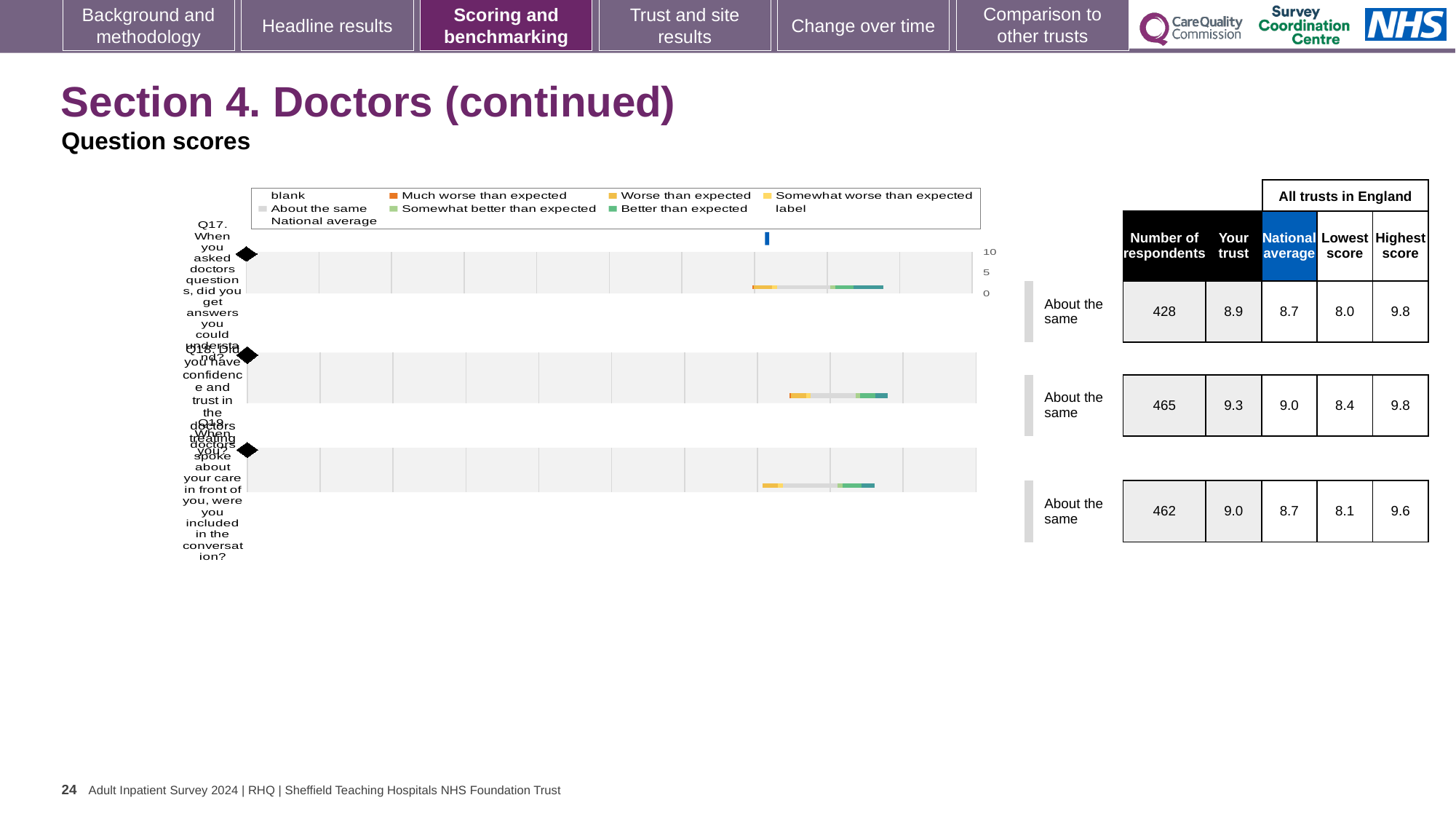
What kind of chart is used to show the question scores for Q17, Q18 and Q19? bar chart In the chart legend, what does the blue line marker represent? National average In the table beside the charts, what is the 'Your trust' score for Q17? 8.9 How many questions (Q17, Q18, Q19) have a benchmarking chart on this slide? 3 In the table beside the charts, how many respondents answered Q19? 462 In the table beside the charts, what is the Highest score for Q18? 9.8 In the table beside the charts, what is the National average score for Q18? 9.0 What benchmark category is shown next to the Q19 chart? About the same Which question has the highest 'Your trust' score in the table? Q18 For Q18, which is larger: the 'Your trust' score or the National average? Your trust What is the highest tick value shown on the score axis of the charts? 10 For Q17, what is the difference between the Highest score and the Lowest score in the table? 1.8